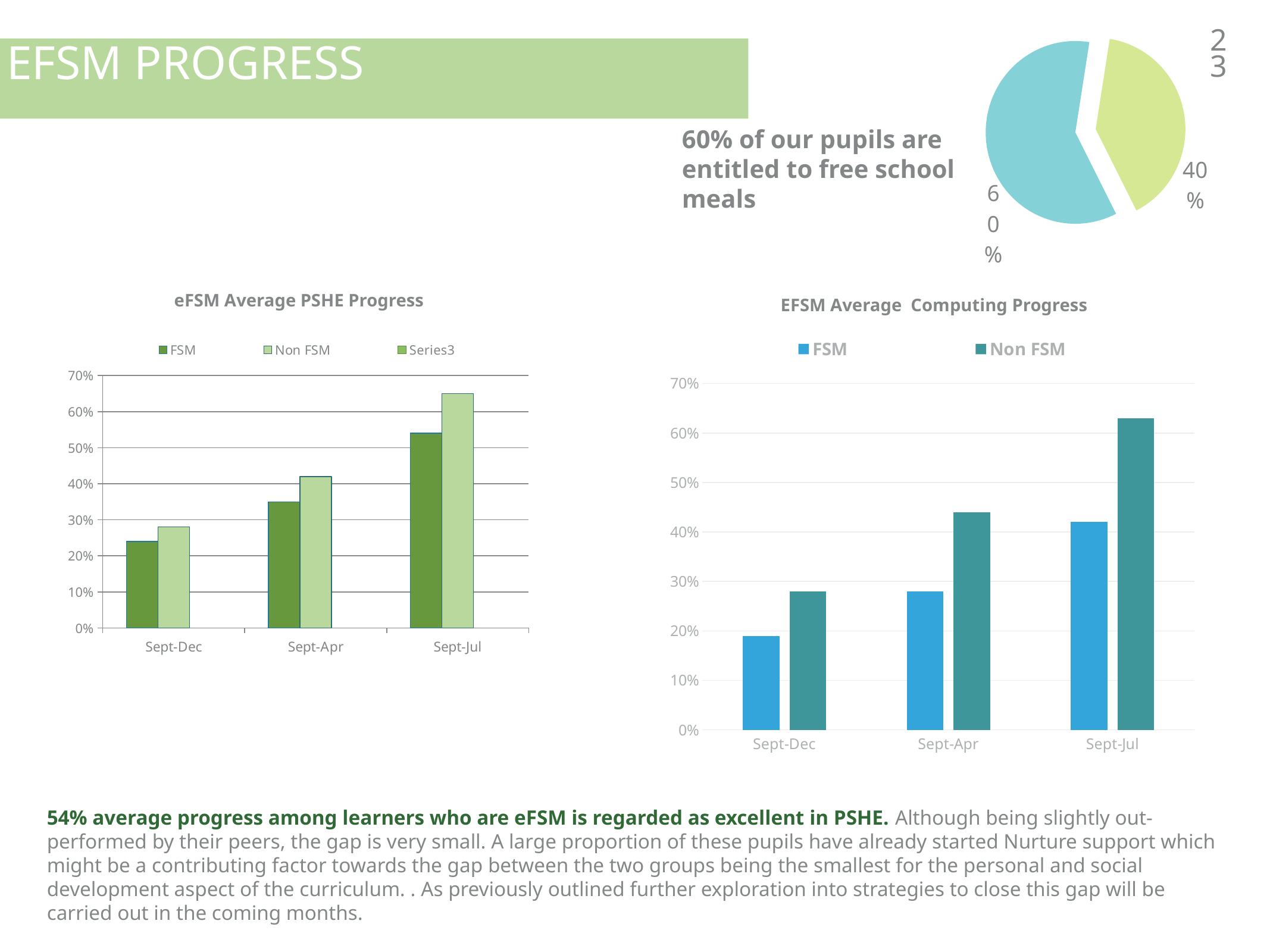
In the pie chart at the top right of the slide, what share does the larger slice represent? 60% In the eFSM Average PSHE Progress chart, is the Non FSM value for Sept-Jul greater or less than 60%? greater In the EFSM Average Computing Progress chart, how many series does the legend list? 2 What kind of chart is the EFSM Average Computing Progress chart? bar chart In the EFSM Average Computing Progress chart, which category has the highest Non FSM value? Sept-Jul In the eFSM Average PSHE Progress chart, is the FSM value for Sept-Jul greater or less than 50%? greater In the eFSM Average PSHE Progress chart, which category has the lowest FSM value? Sept-Dec In the EFSM Average Computing Progress chart, is the FSM value for Sept-Apr greater or less than 30%? less In the eFSM Average PSHE Progress chart, how many series does the legend list? 3 In the EFSM Average Computing Progress chart, do the FSM values rise or fall from Sept-Dec to Sept-Jul? rise In the eFSM Average PSHE Progress chart, how many categories are shown on the x axis? 3